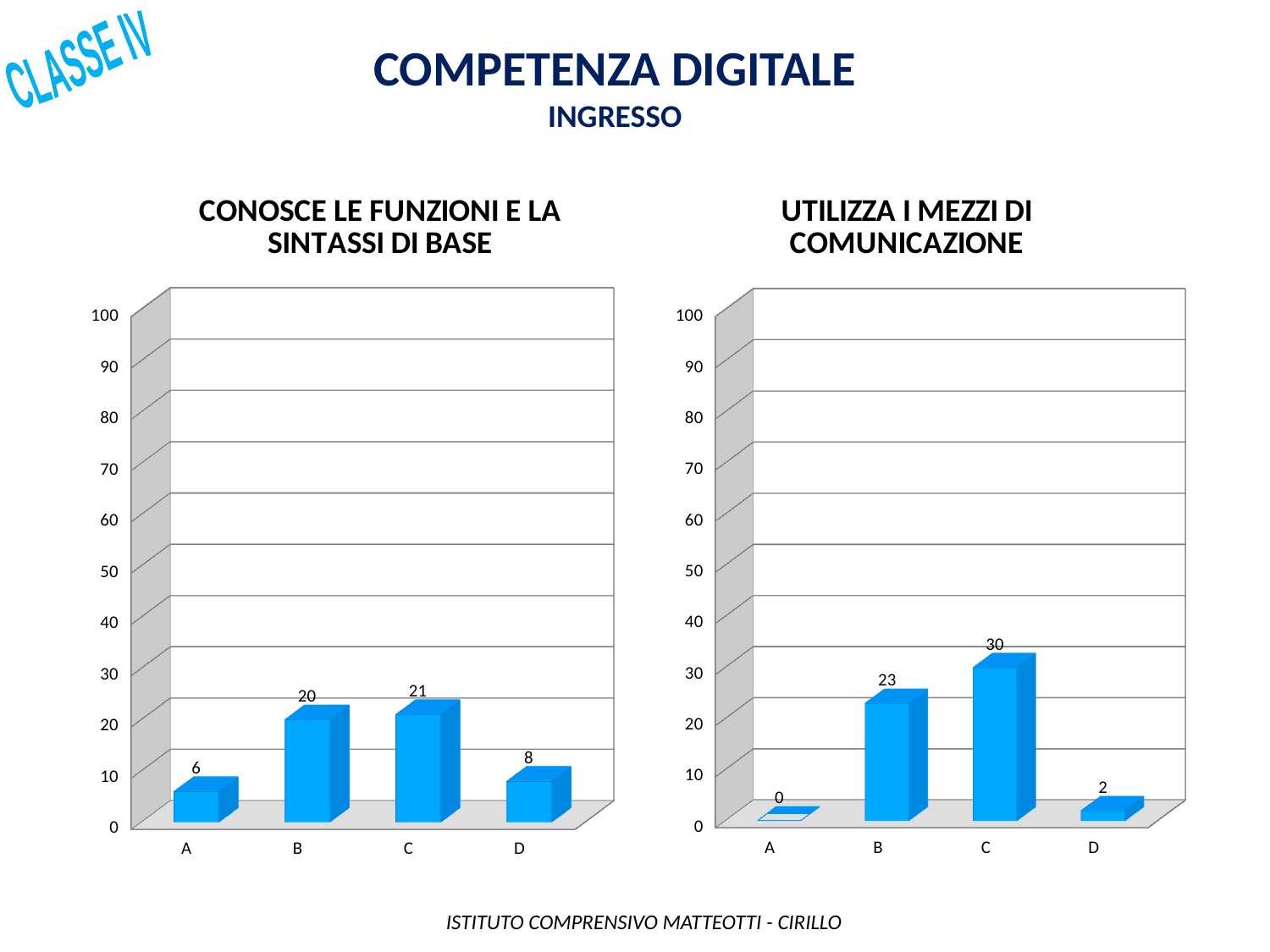
In the 'CONOSCE LE FUNZIONI E LA SINTASSI DI BASE' chart, what is the difference between the values for C and D? 13 What kind of chart is the 'UTILIZZA I MEZZI DI COMUNICAZIONE' chart? Bar chart In the 'CONOSCE LE FUNZIONI E LA SINTASSI DI BASE' chart, what is the value for category A? 6 In the 'UTILIZZA I MEZZI DI COMUNICAZIONE' chart, what is the value for category C? 30 In the 'CONOSCE LE FUNZIONI E LA SINTASSI DI BASE' chart, what is the value for category B? 20 In the 'UTILIZZA I MEZZI DI COMUNICAZIONE' chart, what is the difference between the values for C and B? 7 In the 'UTILIZZA I MEZZI DI COMUNICAZIONE' chart, which category has the highest value? C In the 'UTILIZZA I MEZZI DI COMUNICAZIONE' chart, what is the value for category A? 0 In the 'UTILIZZA I MEZZI DI COMUNICAZIONE' chart, which is larger, the value for B or the value for D? B How many categories are shown on the x axis of the 'CONOSCE LE FUNZIONI E LA SINTASSI DI BASE' chart? 4 In the 'CONOSCE LE FUNZIONI E LA SINTASSI DI BASE' chart, which category has the highest value? C In the 'CONOSCE LE FUNZIONI E LA SINTASSI DI BASE' chart, which category has the lowest value? A